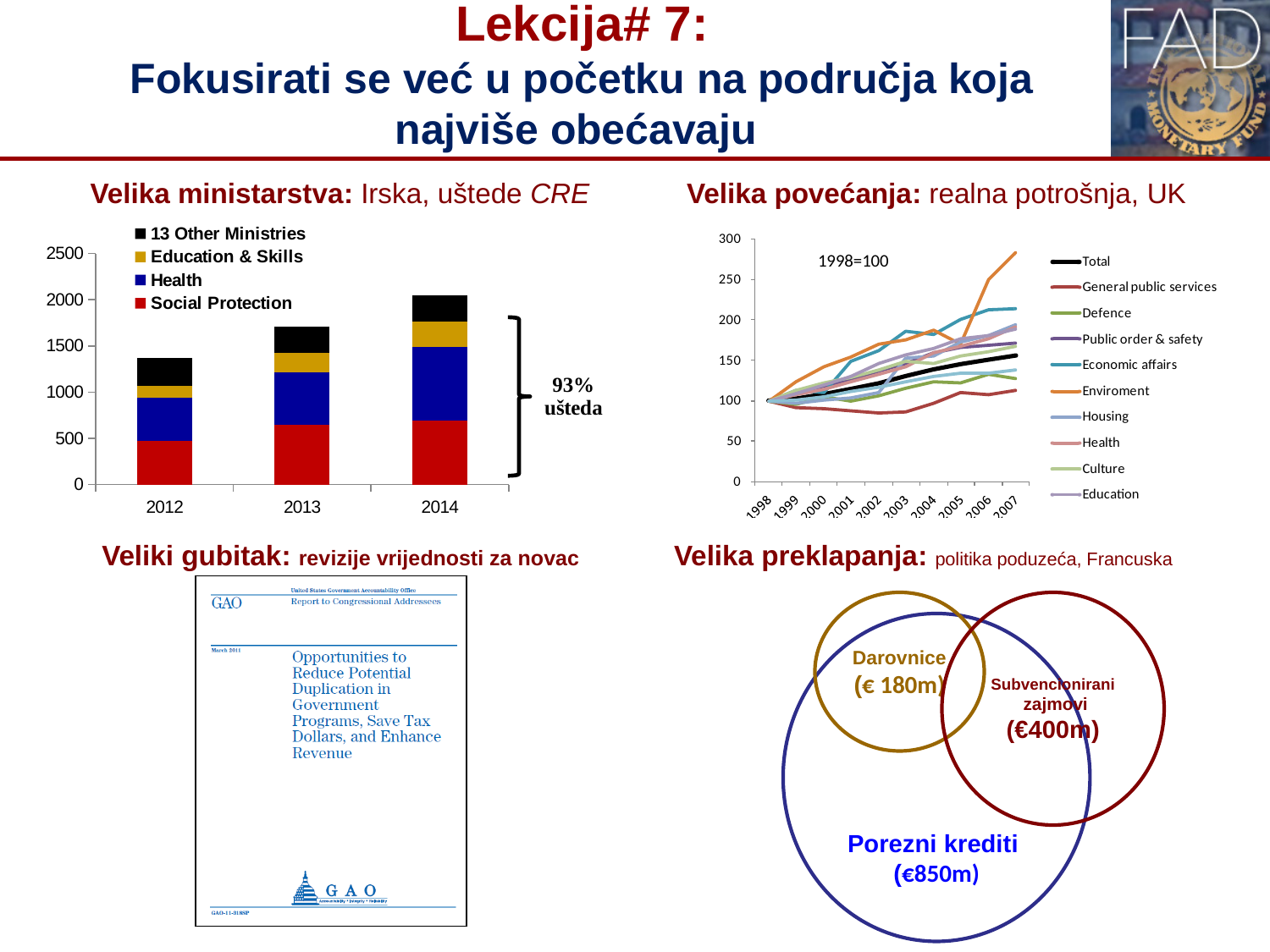
How many years are shown on the x axis of the 'Velika ministarstva' bar chart? 3 What kind of chart is the 'Velika povećanja: realna potrošnja, UK' chart? line chart How many series does the legend of the 'Velika ministarstva' bar chart list? 4 How many series does the legend of the 'Velika povećanja' line chart list? 10 In the 'Velika ministarstva' bar chart, do the stacked totals rise or fall from 2012 to 2014? rise In the 'Velika ministarstva' bar chart, is the total for 2012 greater or less than 1500? less In the 'Velika povećanja' line chart, is the value for Enviroment in 2007 greater or less than 250? greater What base-year annotation is printed inside the 'Velika povećanja' line chart? 1998=100 In the 'Velika ministarstva' bar chart, is the total for 2014 greater or less than 1500? greater In the 'Velika povećanja' line chart, which series has the highest value in 2007? Enviroment In the 'Velika ministarstva' bar chart, which year has the highest stacked total? 2014 What kind of chart is the 'Velika ministarstva: Irska, uštede CRE' chart? stacked bar chart